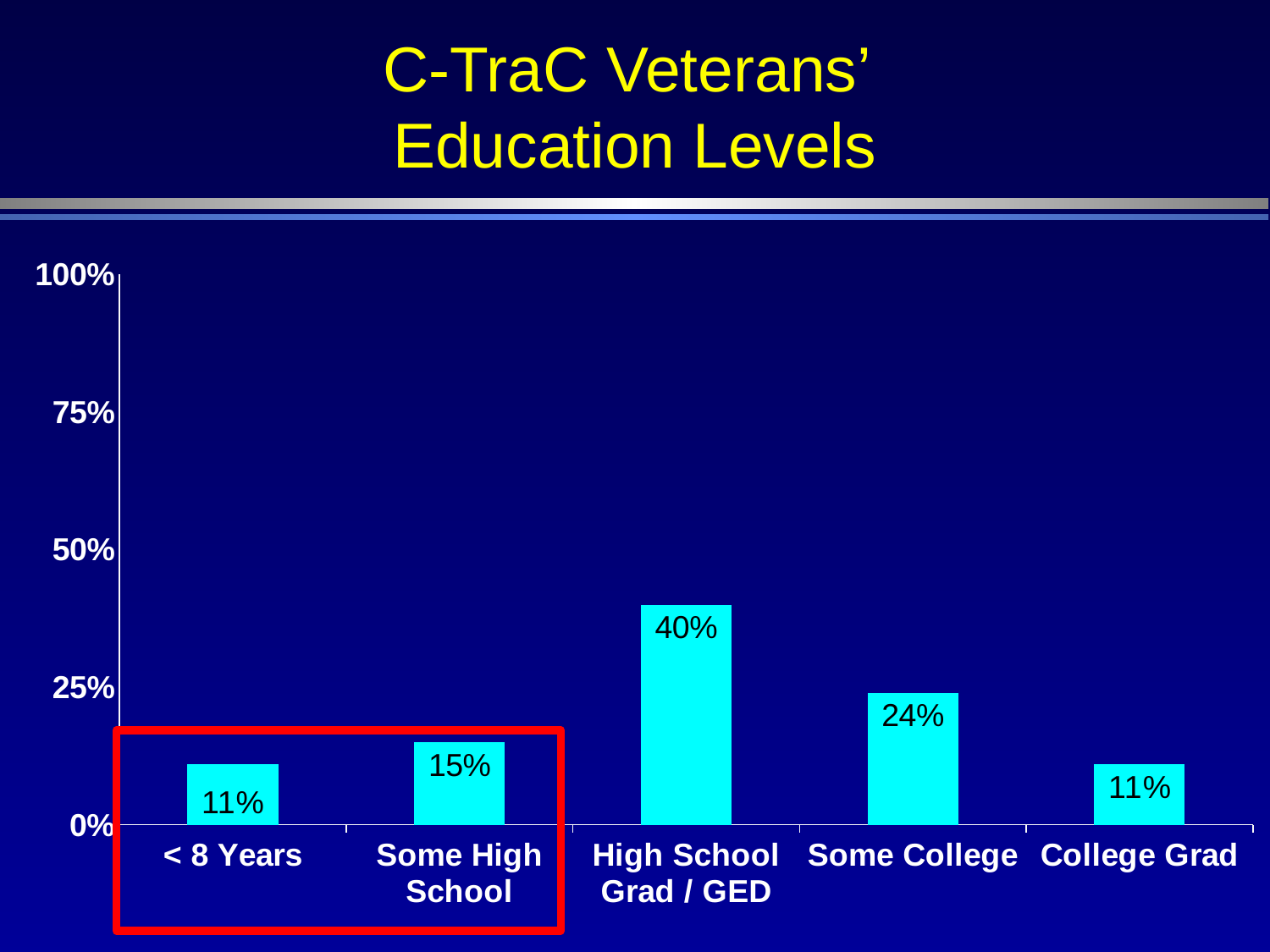
What is the value for Some High School? 15% What is the combined value of the two categories enclosed in the red box (< 8 Years and Some High School)? 26% Which education level has the highest percentage? High School Grad / GED Which is larger, the value for Some College or the value for College Grad? Some College What kind of chart is shown on the slide? bar chart How many education level categories are shown on the chart? 5 Is the value for High School Grad / GED greater or less than 50%? less What is the difference between the High School Grad / GED value and the Some College value? 16% What is the title of the chart? C-TraC Veterans' Education Levels What percentage of C-TraC veterans have a High School Grad / GED education level? 40% What is the difference between the Some High School value and the < 8 Years value? 4% What is the value for Some College? 24%